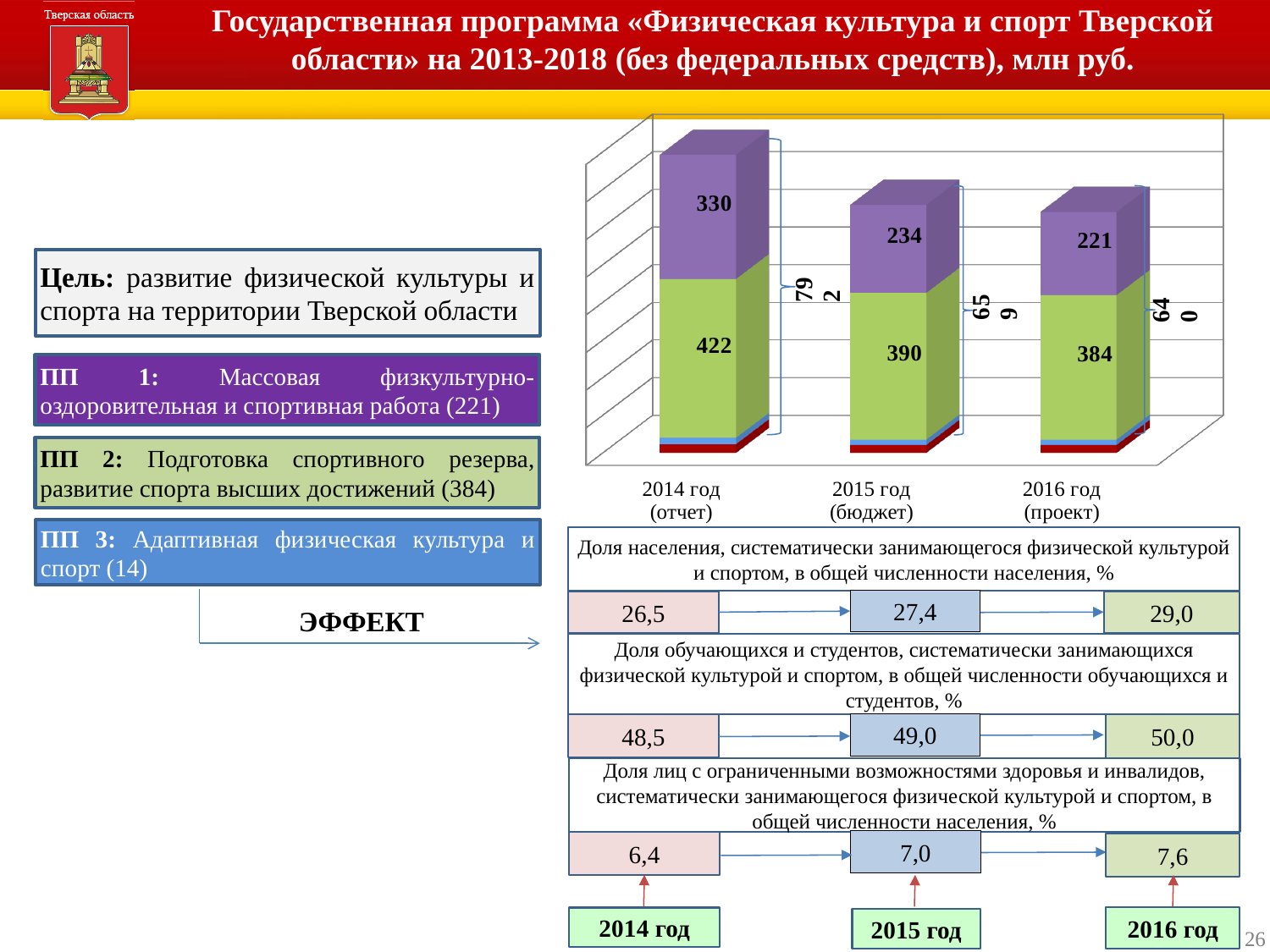
What total is printed next to the bar for 2015 год (бюджет)? 659 What is the value of the purple (top) segment for 2014 год (отчет)? 330 What total is printed next to the bar for 2014 год (отчет)? 792 Which is larger, the purple segment for 2015 год (бюджет) or for 2016 год (проект)? 2015 год (бюджет) Do the green segment values rise or fall from 2014 to 2016? Fall Which year has the highest value for the green segment? 2014 год (отчет) What is the value of the green segment for 2015 год (бюджет)? 390 What is the value of the green segment for 2016 год (проект)? 384 What kind of chart is shown on the slide? Stacked bar chart What is the difference between the purple segment values for 2014 год and 2015 год? 96 How many years (categories) are shown on the x axis of the chart? 3 What is the value of the purple (top) segment for 2016 год (проект)? 221